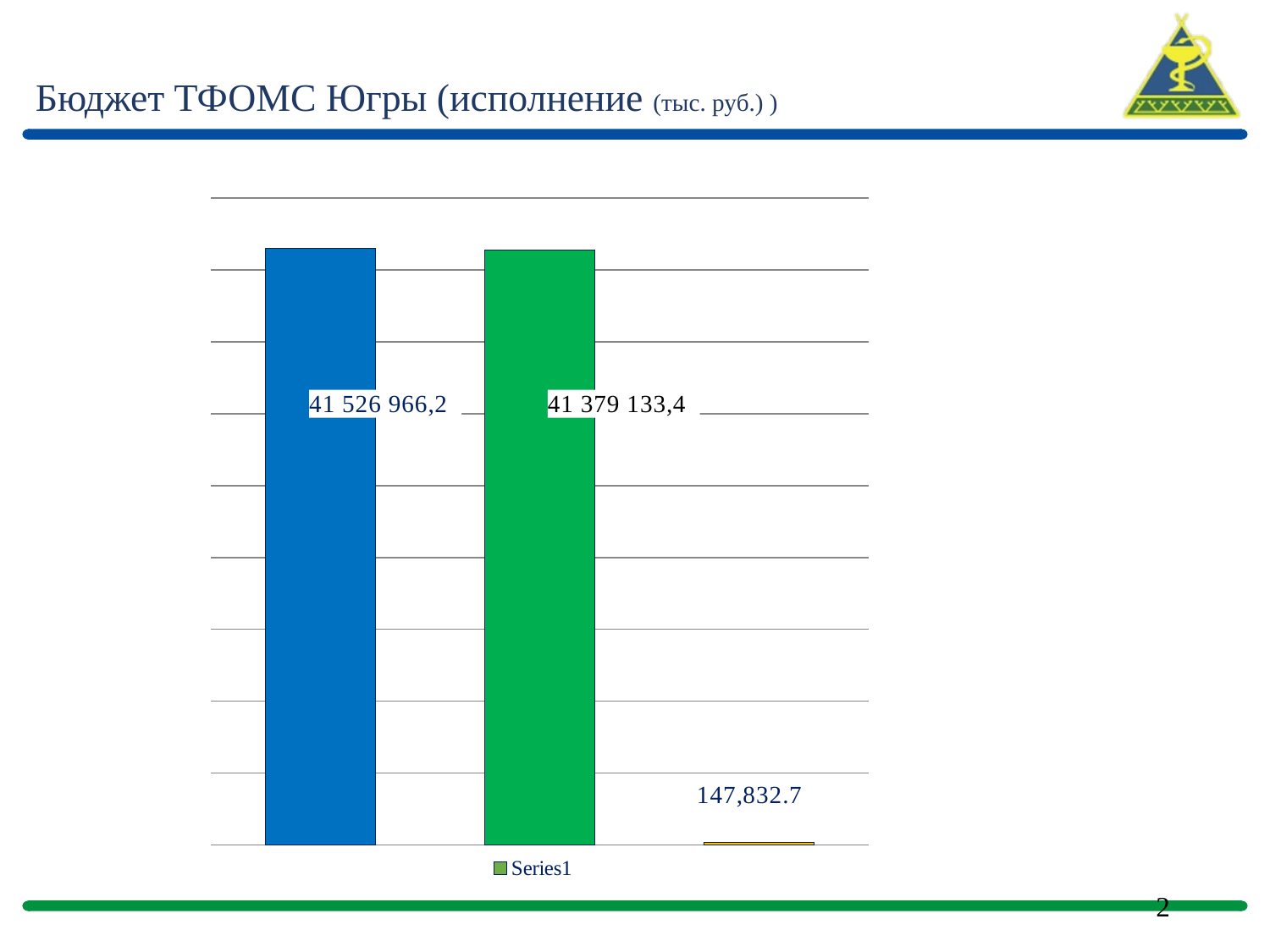
What kind of chart is shown on the slide? bar chart What value is printed on the green bar? 41 379 133,4 Which bar has the highest value? the blue bar Which bar has the lowest value? the yellow bar What value is printed above the small yellow bar on the right? 147,832.7 What entry is shown in the chart legend? Series1 How many bars are plotted in the chart? 3 How many series does the legend list? 1 Which is larger, the value of the blue bar or the value of the green bar? the blue bar What is the title of the slide? Бюджет ТФОМС Югры (исполнение (тыс. руб.)) What value is printed on the blue bar? 41 526 966,2